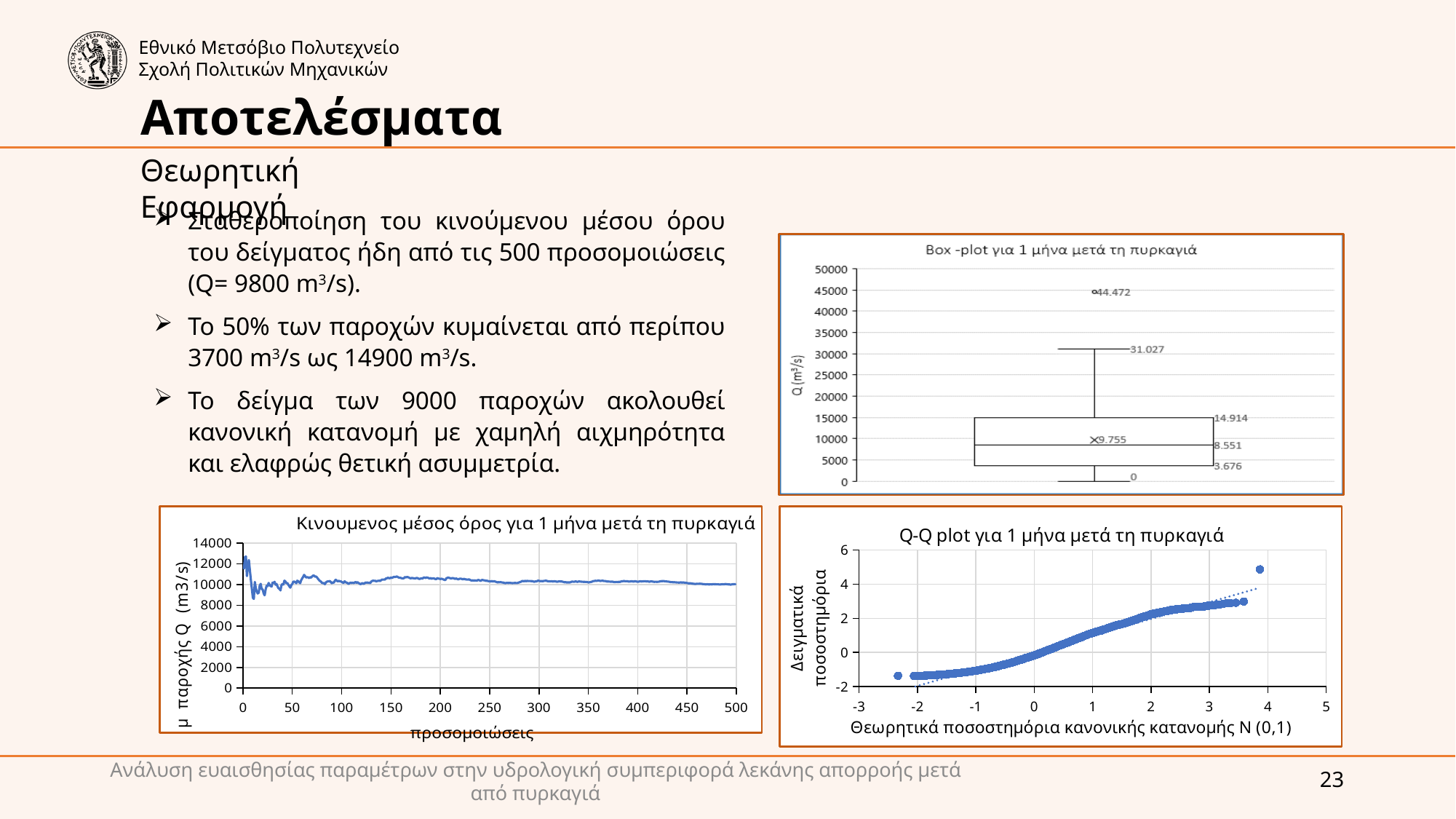
In the box plot chart (top right), what value is printed for the outlier point at the top? 44.472 In the bottom-left line chart, is the value at 500 simulations greater or less than 8000? greater In the bottom-left line chart, does the moving average at the far right (around 500 simulations) lie above or below 12000? below In the bottom-right Q-Q plot, do the plotted points rise or fall as the theoretical quantiles increase along the x axis? rise In the box plot chart (top right), what value is printed at the upper whisker? 31.027 In the box plot chart (top right), what is the difference between the top edge of the box (14.914) and the bottom edge of the box (3.676)? 11.238 In the box plot chart (top right), what value is printed next to the x marker inside the box? 9.755 What is the title of the chart in the top right of the slide? Box -plot για 1 μήνα μετά τη πυρκαγιά In the box plot chart (top right), what value is printed at the top edge of the box? 14.914 In the box plot chart (top right), what value is printed at the bottom edge of the box? 3.676 In the box plot chart (top right), which is larger: the value at the upper whisker or the value at the top edge of the box? the upper whisker (31.027) What kind of chart is the bottom-left chart titled 'Κινουμενος μέσος όρος για 1 μήνα μετά τη πυρκαγιά'? line chart